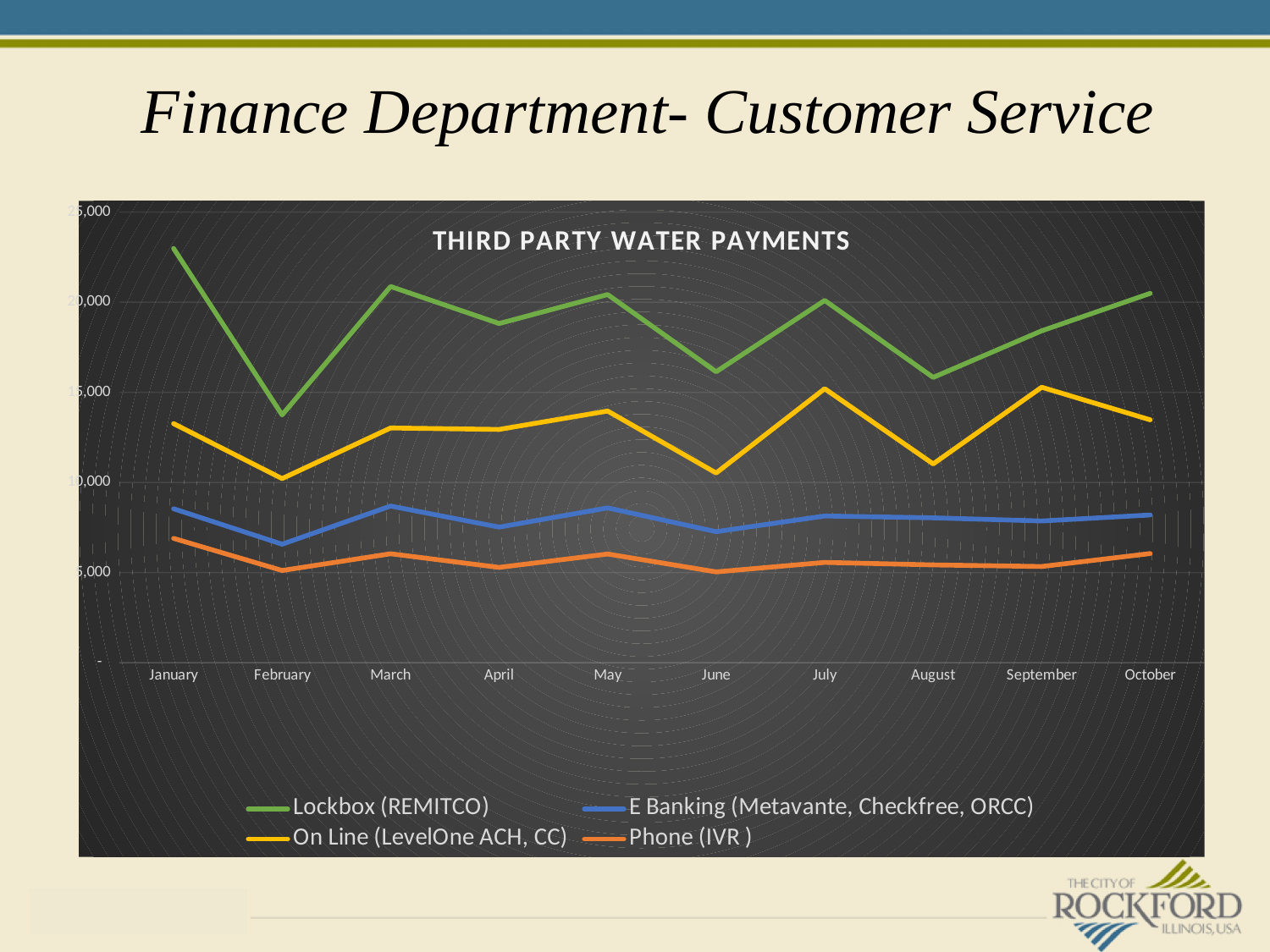
Is the Lockbox (REMITCO) value for January greater or less than 20,000? greater What kind of chart is shown on the slide? Line chart Which is larger in March, Lockbox (REMITCO) or On Line (LevelOne ACH, CC)? Lockbox (REMITCO) What is the title of the chart? THIRD PARTY WATER PAYMENTS In which month is the Lockbox (REMITCO) value highest? January In which month is the Lockbox (REMITCO) value lowest? February Which series has the highest values across all months? Lockbox (REMITCO) Which series has the lowest values across all months? Phone (IVR ) Is the Lockbox (REMITCO) value for February greater or less than 15,000? less Does the Lockbox (REMITCO) line rise or fall from January to February? fall How many months are shown along the x axis? 10 How many series does the legend list? 4